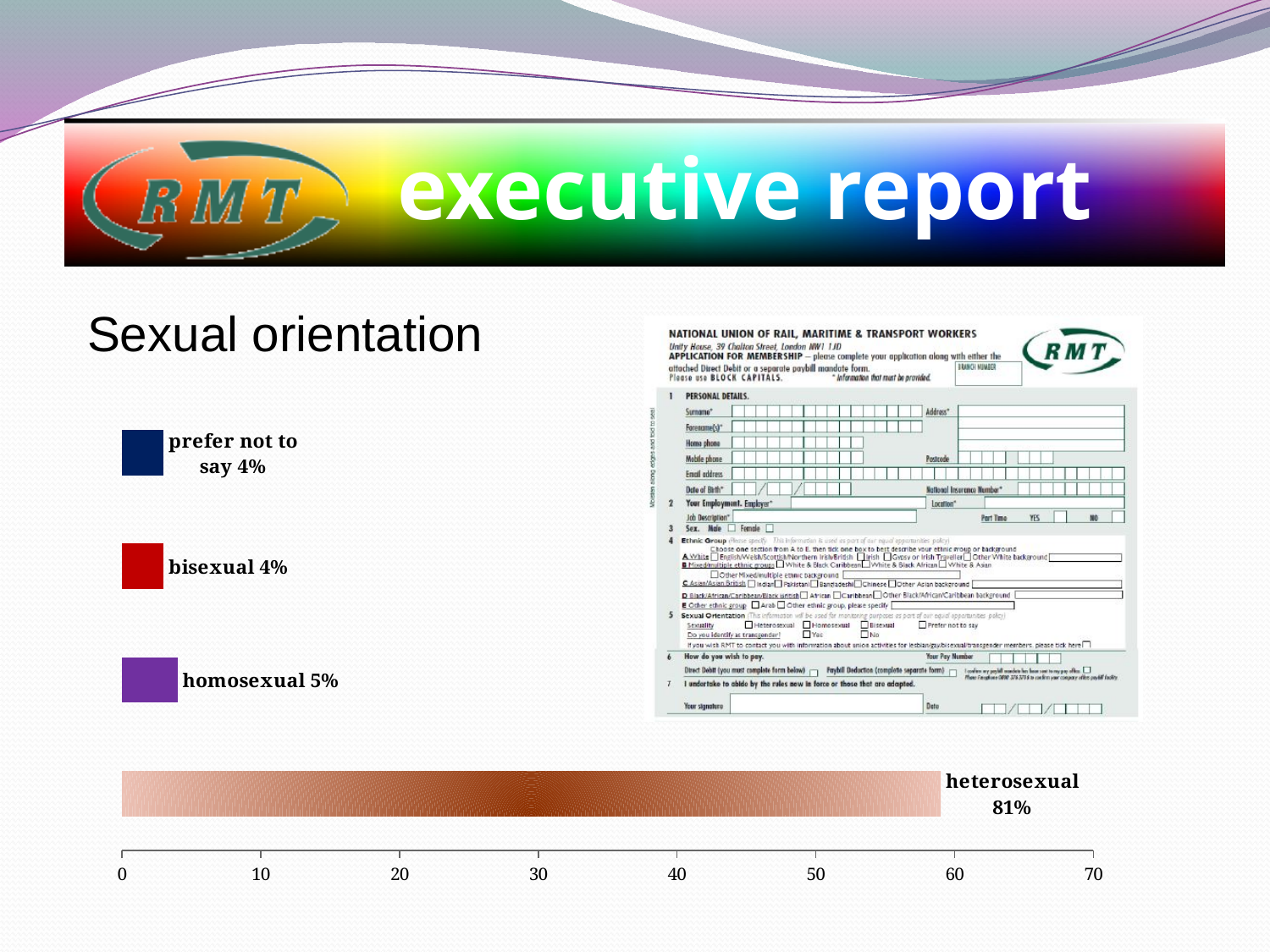
What is the difference between the homosexual and bisexual values in the Sexual orientation chart? 1% How many categories are shown in the Sexual orientation chart? 4 What is the value for bisexual in the Sexual orientation chart? 4% What is the value for homosexual in the Sexual orientation chart? 5% What is the difference between the heterosexual and homosexual values in the Sexual orientation chart? 76% What is the title of the chart on the slide? Sexual orientation Which is larger in the Sexual orientation chart, homosexual or bisexual? homosexual What kind of chart is the Sexual orientation chart? bar chart What is the value for heterosexual in the Sexual orientation chart? 81% Which category has the highest value in the Sexual orientation chart? heterosexual What is the value for 'prefer not to say' in the Sexual orientation chart? 4% Is the heterosexual bar in the Sexual orientation chart greater or less than 40 on the axis? greater